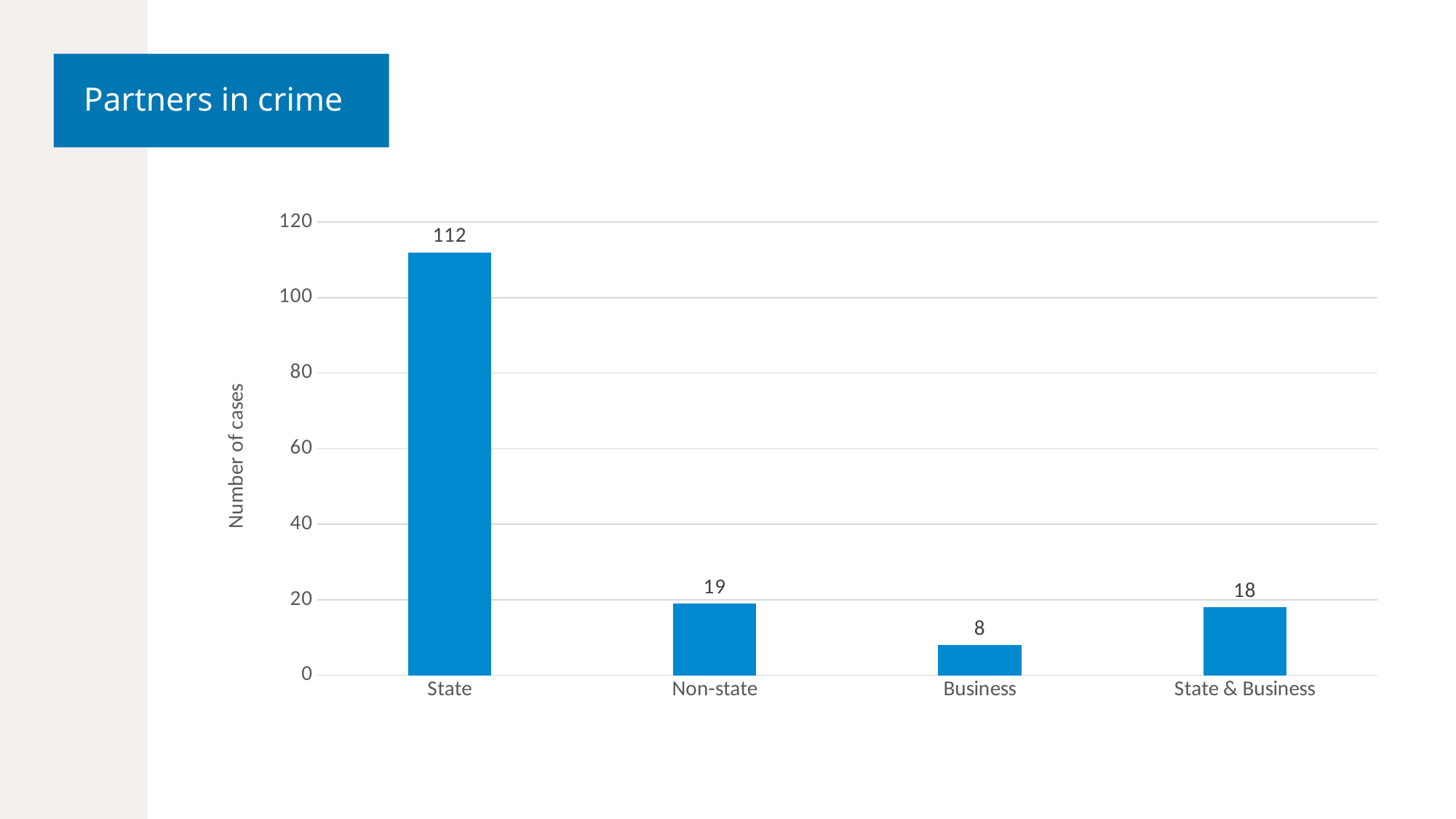
Which category has the lowest number of cases? Business What is the difference in number of cases between State & Business and Business? 10 What kind of chart is shown on the slide? Bar chart What is the number of cases for Non-state? 19 What is the number of cases for State & Business? 18 Which has more cases, Non-state or Business? Non-state How many categories are shown on the x axis? 4 Is the value for State greater or less than 100? greater Which category has the highest number of cases? State What is the number of cases for Business? 8 What is the number of cases for State? 112 What is the difference in number of cases between State and Non-state? 93